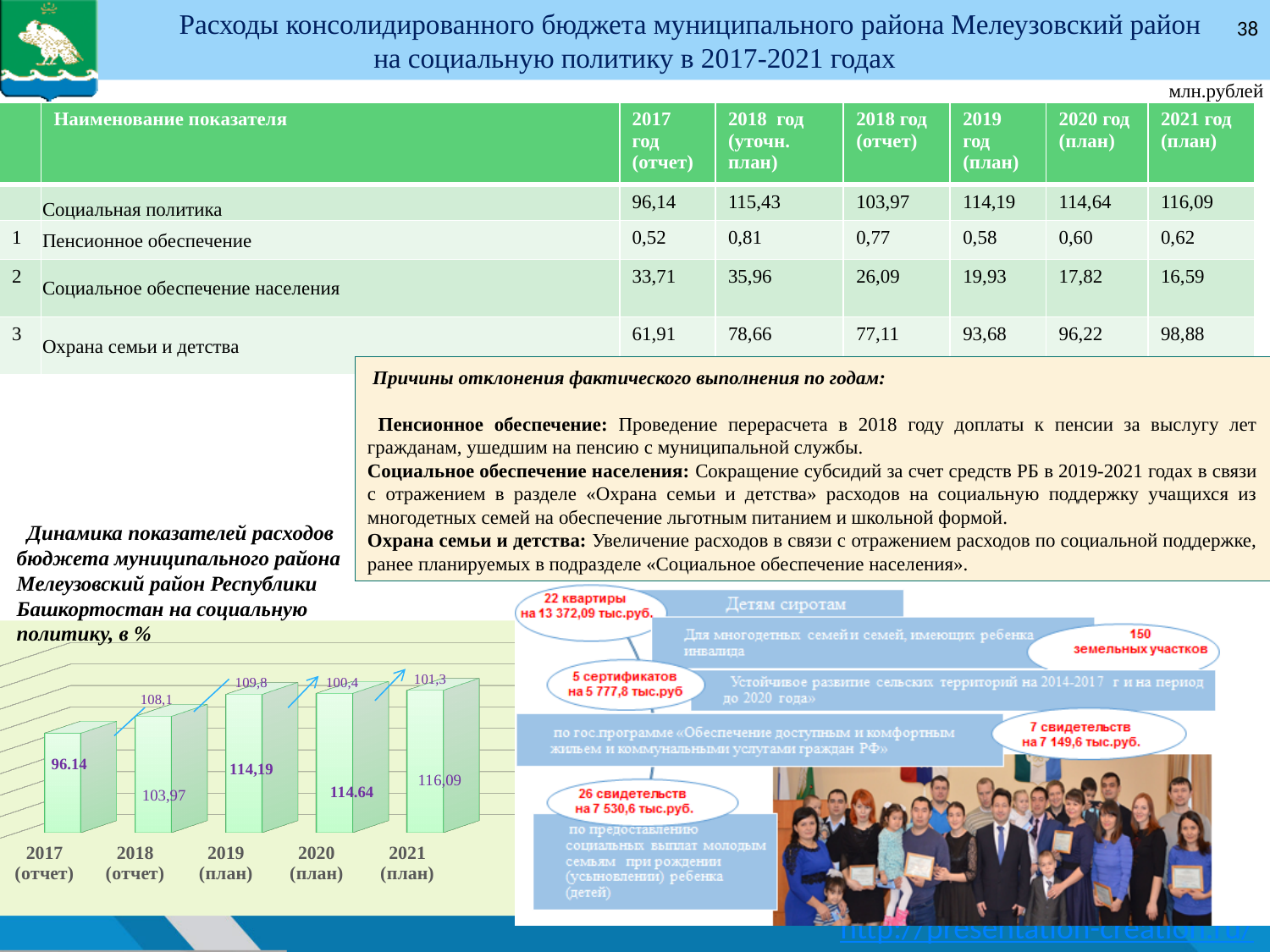
In the bar chart at the bottom left, what is the value for 2018 (отчет)? 103,97 In the bar chart at the bottom left, what is the value for 2017 (отчет)? 96.14 What type of chart is shown at the bottom left of the slide? bar chart In the bar chart at the bottom left, which year has the lowest value? 2017 (отчет) In the bar chart at the bottom left, what is the difference between the 2021 (план) value and the 2017 (отчет) value? 19,95 In the bar chart at the bottom left, do the values rise or fall from 2017 to 2021? rise In the bar chart at the bottom left, which year has the highest value? 2021 (план) In the bar chart at the bottom left, what is the value for 2019 (план)? 114,19 In the bar chart at the bottom left, which is larger: the value for 2018 (отчет) or the value for 2019 (план)? 2019 (план) How many bars are shown in the bar chart at the bottom left? 5 In the bar chart at the bottom left, what is the value for 2021 (план)? 116,09 In the bar chart at the bottom left, what is the difference between the 2018 (отчет) value and the 2017 (отчет) value? 7,83